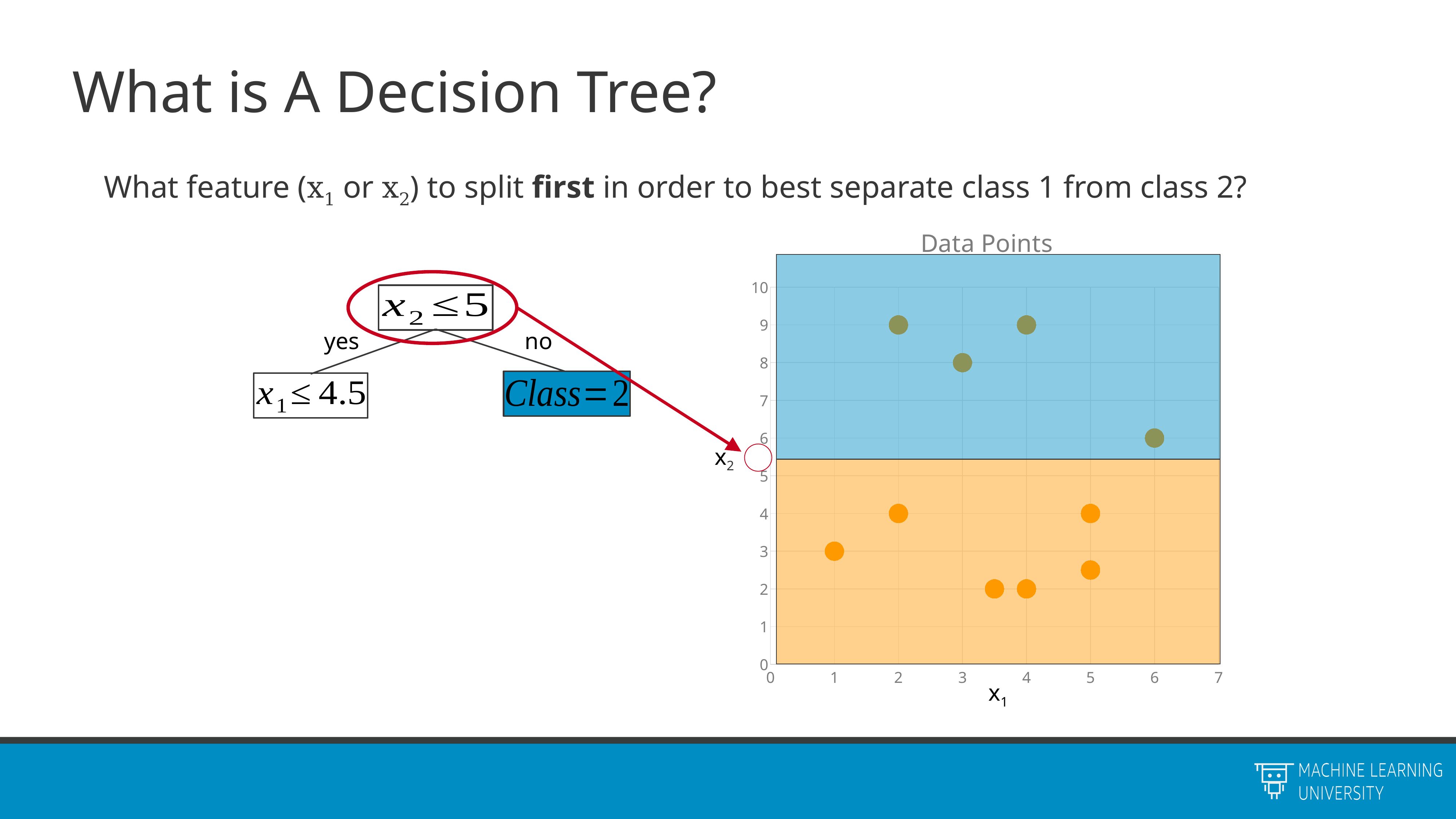
In the "Data Points" chart, what is the x2 value of the orange point at x1 = 1? 3 What kind of chart is the "Data Points" chart? scatter chart In the "Data Points" chart, which point has the larger x2 value: the point at x1 = 1 or the point at x1 = 3? the point at x1 = 3 How many green points are plotted in the "Data Points" chart? 4 What is the title of the chart on the slide? Data Points How many data points are plotted in the "Data Points" chart? 10 In the "Data Points" chart, is the x2 value of the green point at x1 = 6 greater or less than 5? greater How many orange points are plotted in the "Data Points" chart? 6 In the "Data Points" chart, what is the highest x2 value among the plotted points? 9 In the "Data Points" chart, what is the x2 value of the green point at x1 = 3? 8 What is the label of the horizontal axis in the "Data Points" chart? x1 In the "Data Points" chart, what is the difference in x2 between the green point at x1 = 3 and the orange point at x1 = 1? 5